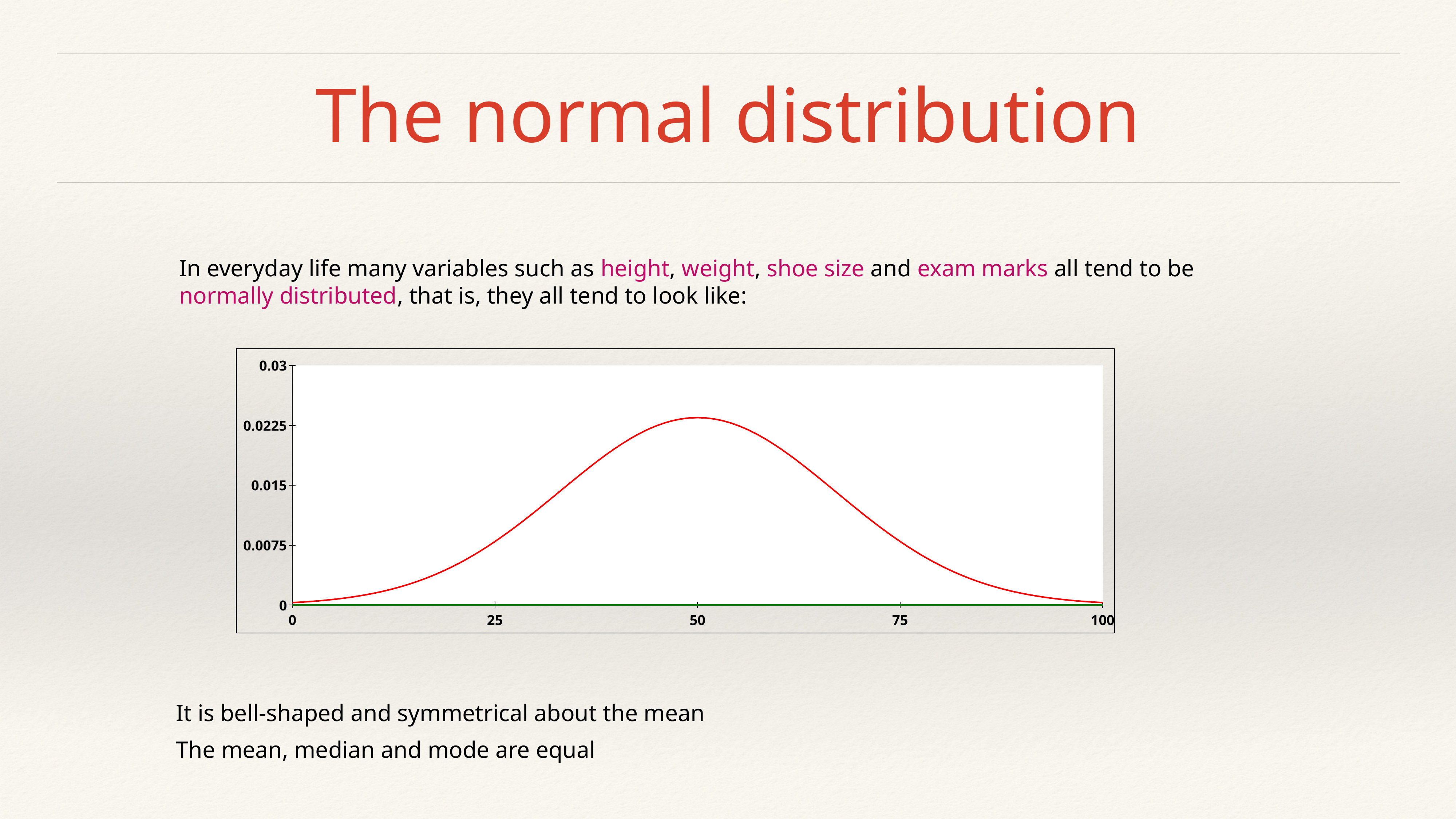
How many labelled tick marks are on the x axis? 5 Does the curve rise or fall as x goes from 0 to 50? rise At which x-axis value does the curve reach its highest point? 50 Is the value of the curve at x = 0 greater or less than 0.0075? less Does the curve rise or fall as x goes from 50 to 100? fall Is the peak of the curve greater or less than 0.03? less What is the highest value labelled on the y axis? 0.03 What kind of chart is shown on the slide? line chart Is the value of the curve at x = 50 greater or less than 0.015? greater What colour is the plotted curve? red